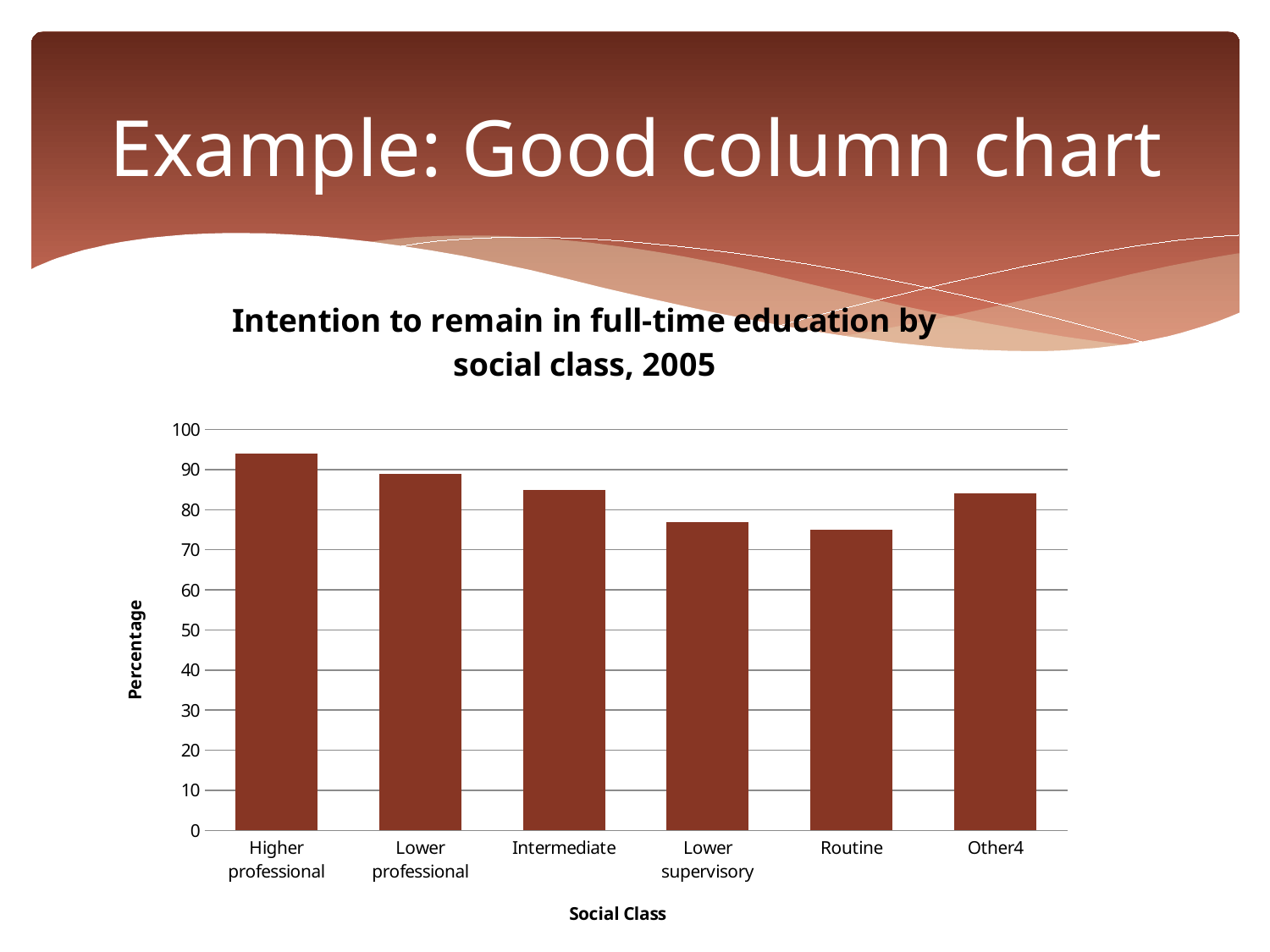
How many social class categories are plotted on the chart? 6 Is the value for Other4 greater or less than 80? greater Is the value for Lower supervisory greater or less than 80? less Which is larger, the value for Higher professional or the value for Routine? Higher professional What kind of chart is shown on the slide? Bar chart Is the value for Higher professional greater or less than 90? greater Do the values rise or fall from Higher professional through to Routine along the x axis? fall Which social class has the highest percentage intending to remain in full-time education? Higher professional Which is larger, the value for Lower professional or the value for Lower supervisory? Lower professional What is the label on the vertical axis of the chart? Percentage